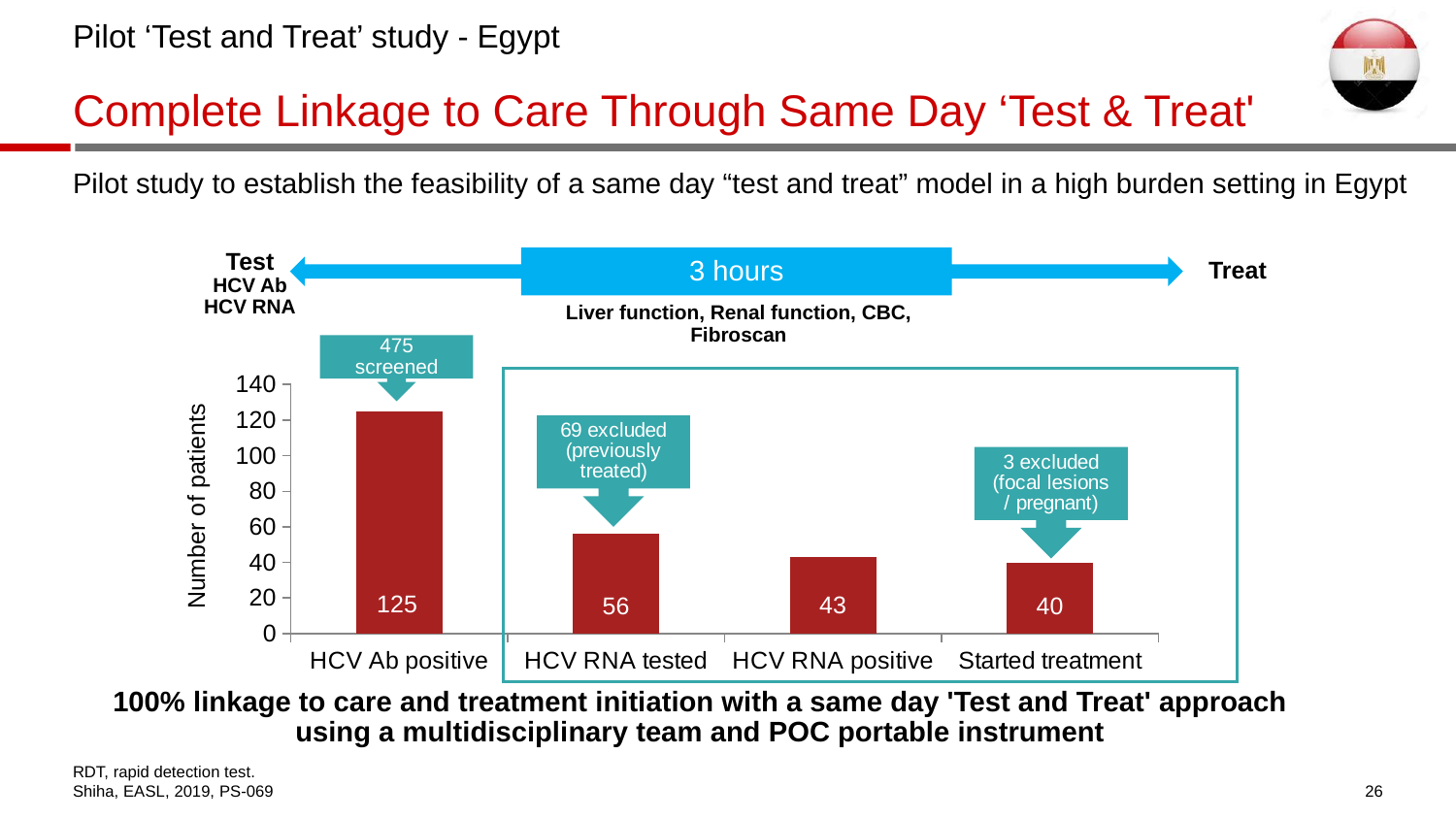
Which category has the lowest number of patients? Started treatment How many patients were HCV RNA positive? 43 How many patients started treatment? 40 How many patients were HCV Ab positive? 125 What is the label of the y axis of the chart? Number of patients How many categories are shown on the x axis of the chart? 4 How many patients were HCV RNA tested? 56 Which is larger, the number HCV RNA tested or the number HCV RNA positive? HCV RNA tested What is the difference between the number of HCV RNA positive patients and the number who started treatment? 3 What is the difference between the number of HCV Ab positive patients and the number HCV RNA tested? 69 Which category has the highest number of patients? HCV Ab positive What kind of chart is shown on the slide? Bar chart